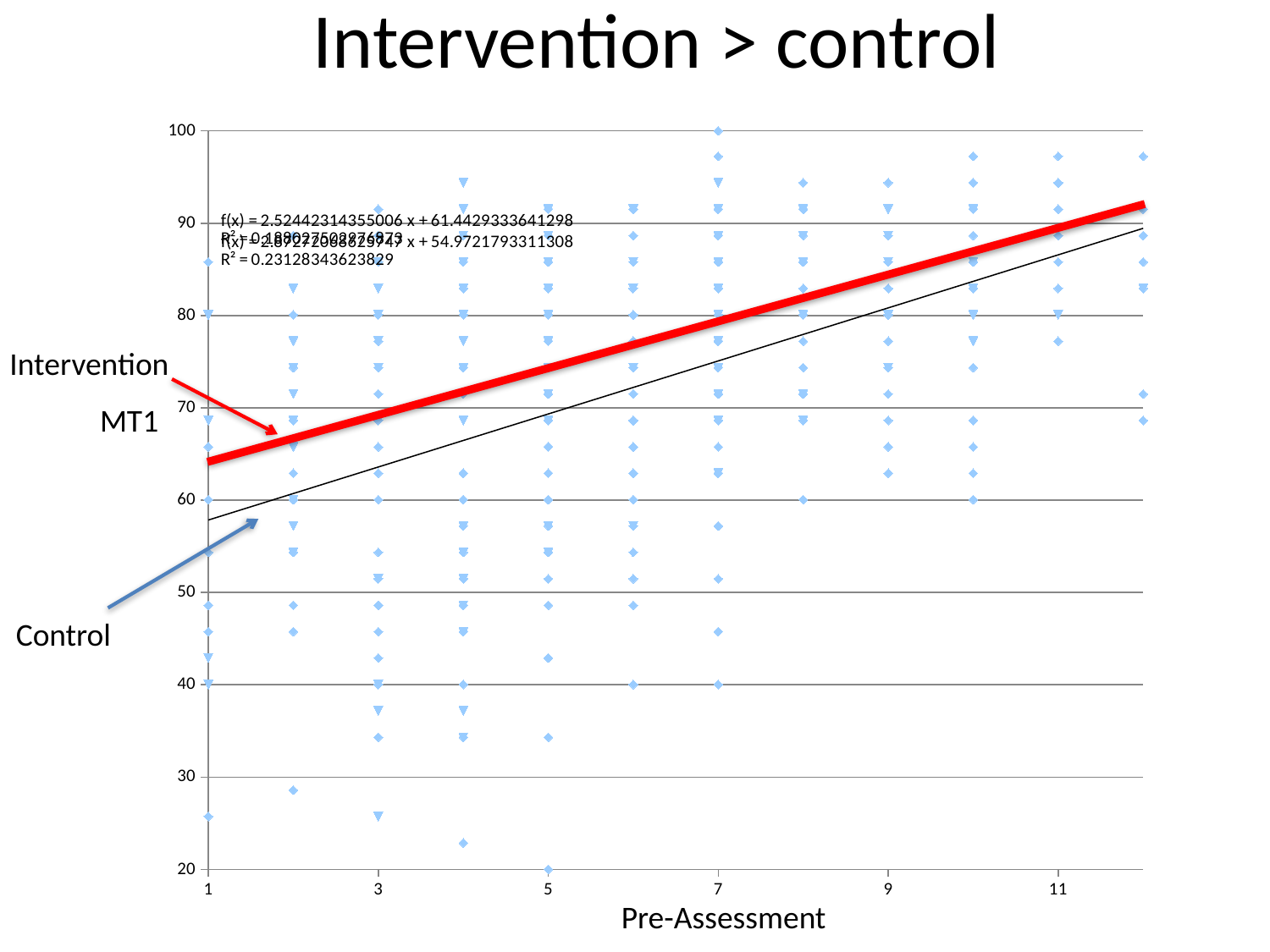
What is the label of the x axis? Pre-Assessment What is the lowest MT1 value plotted on the chart? 20 What is the R² value printed for the second trend line? 0.23128343623829 What kind of chart is shown on the slide? scatter chart What is the title of the chart? Intervention > control What is the slope shown in the first trend line equation, f(x) = ? x + 61.4429333641298? 2.52442314355006 Which trend line is higher across the chart, Intervention or Control? Intervention Is the Control trend line at Pre-Assessment 1 greater or less than 60? less What is the highest MT1 value plotted on the chart? 100 How many data series are annotated on the chart? 2 Is the Intervention trend line at Pre-Assessment 1 greater or less than 60? greater Do the trend lines rise or fall as Pre-Assessment increases? rise